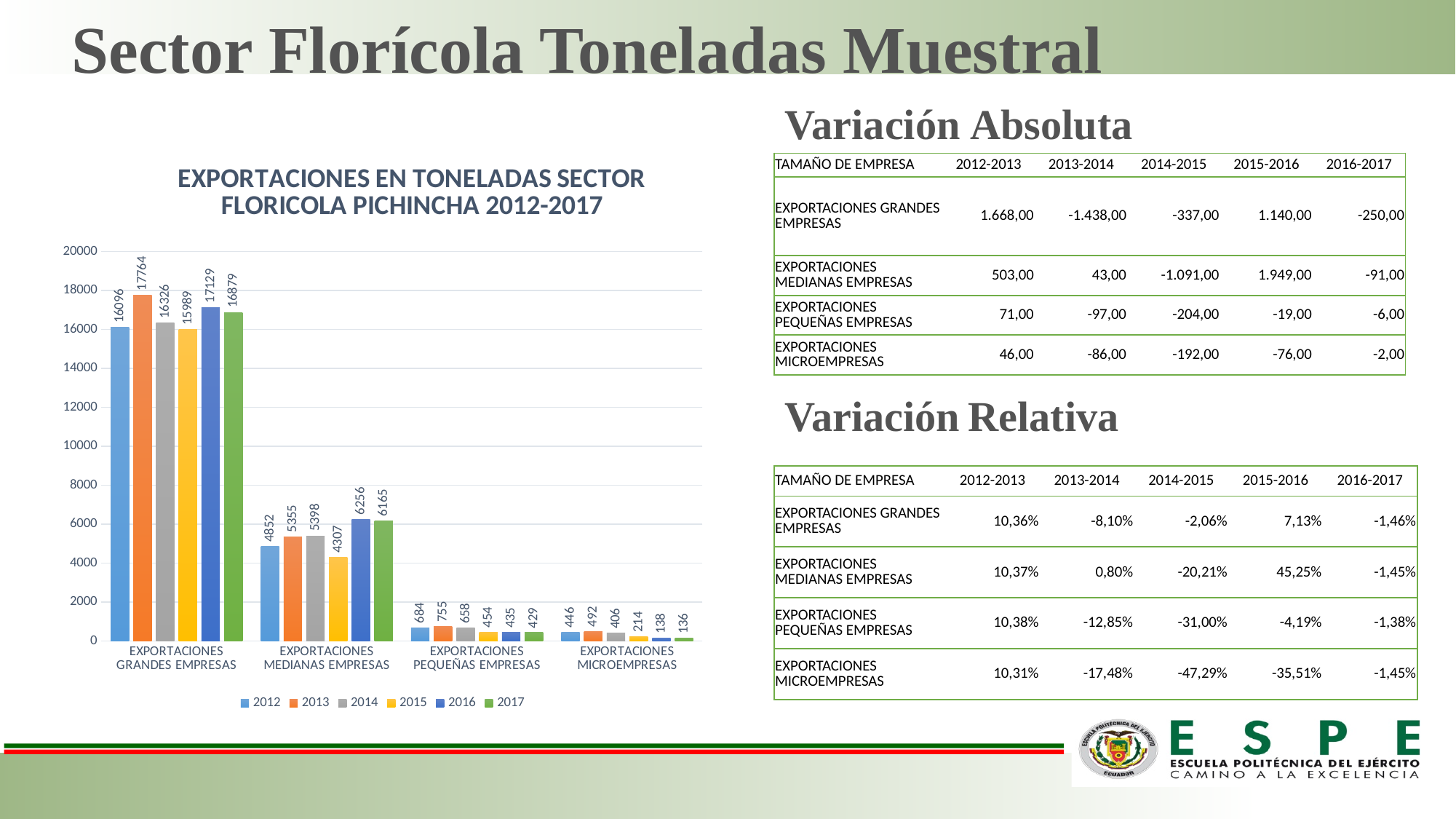
What kind of chart is shown on the slide? bar chart What is the value for EXPORTACIONES GRANDES EMPRESAS in 2013? 17764 Which year has the highest value for EXPORTACIONES GRANDES EMPRESAS? 2013 What is the difference between the 2013 and 2012 values for EXPORTACIONES GRANDES EMPRESAS? 1668 Is the value for EXPORTACIONES MEDIANAS EMPRESAS in 2016 greater or less than 6000? greater Which is larger for EXPORTACIONES PEQUEÑAS EMPRESAS, the 2012 value or the 2013 value? 2013 How many company-size categories are shown on the x axis? 4 What is the value for EXPORTACIONES MEDIANAS EMPRESAS in 2016? 6256 Do the values for EXPORTACIONES MICROEMPRESAS rise or fall from 2013 to 2017? fall How many series does the legend list? 6 Which year has the lowest value for EXPORTACIONES MEDIANAS EMPRESAS? 2015 What is the value for EXPORTACIONES MICROEMPRESAS in 2017? 136